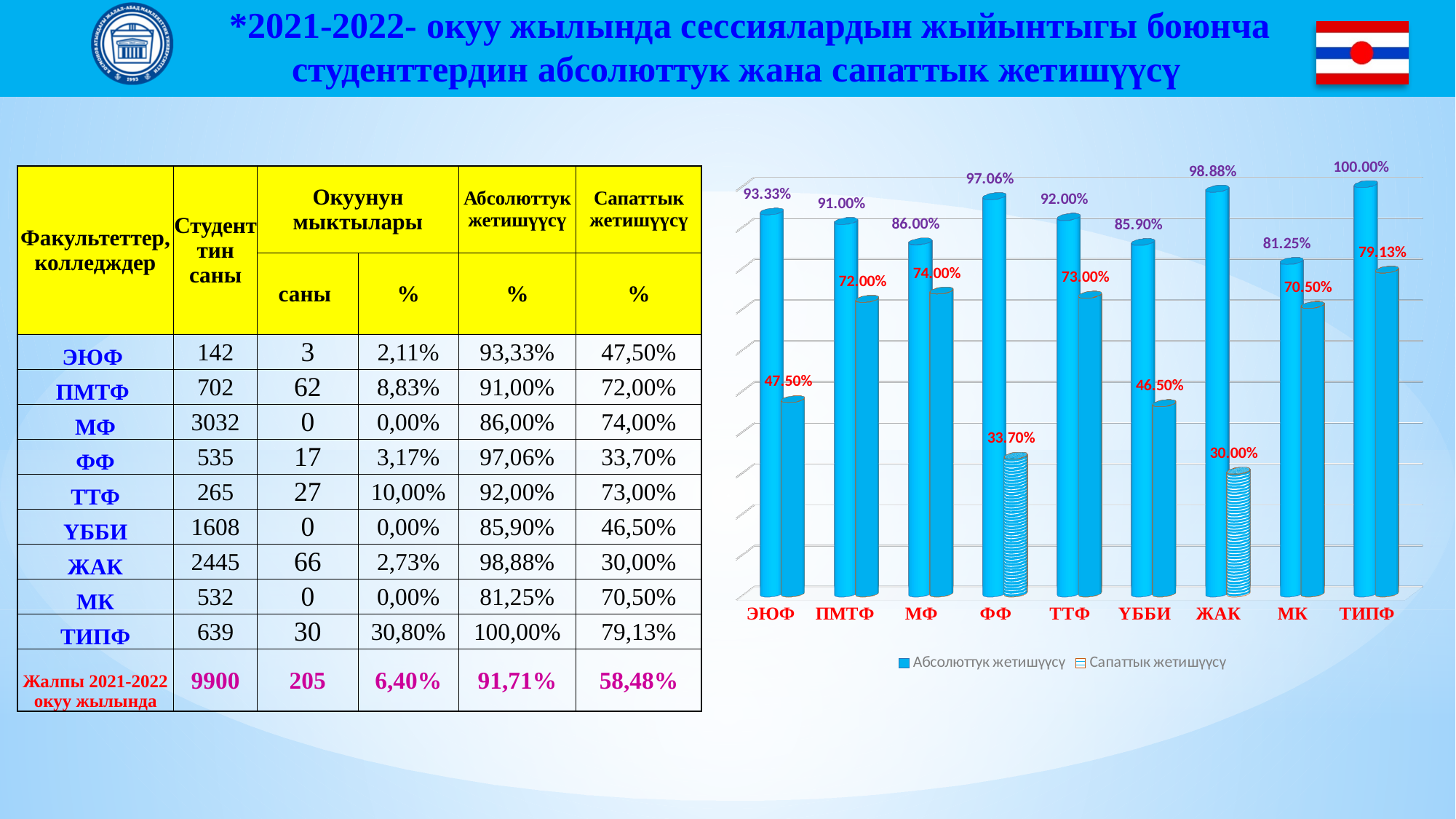
How many faculties are shown on the x axis of the chart? 9 What is the Сапаттык жетишүүсү value for ЖАК in the chart? 30.00% What kind of chart is shown on the slide? bar chart What is the Абсолюттук жетишүүсү value for ФФ in the chart? 97.06% How many series does the chart legend list? 2 Which faculty has the lowest Абсолюттук жетишүүсү in the chart? МК What are the two series named in the chart legend? Абсолюттук жетишүүсү and Сапаттык жетишүүсү In the chart, which is larger: the Сапаттык жетишүүсү for ПМТФ or for МФ? МФ Which faculty has the lowest Сапаттык жетишүүсү in the chart? ЖАК What is the difference between the Абсолюттук жетишүүсү and Сапаттык жетишүүсү values for ЭЮФ in the chart? 45.83% What is the Сапаттык жетишүүсү value for ТИПФ in the chart? 79.13% Which faculty has the highest Абсолюттук жетишүүсү in the chart? ТИПФ